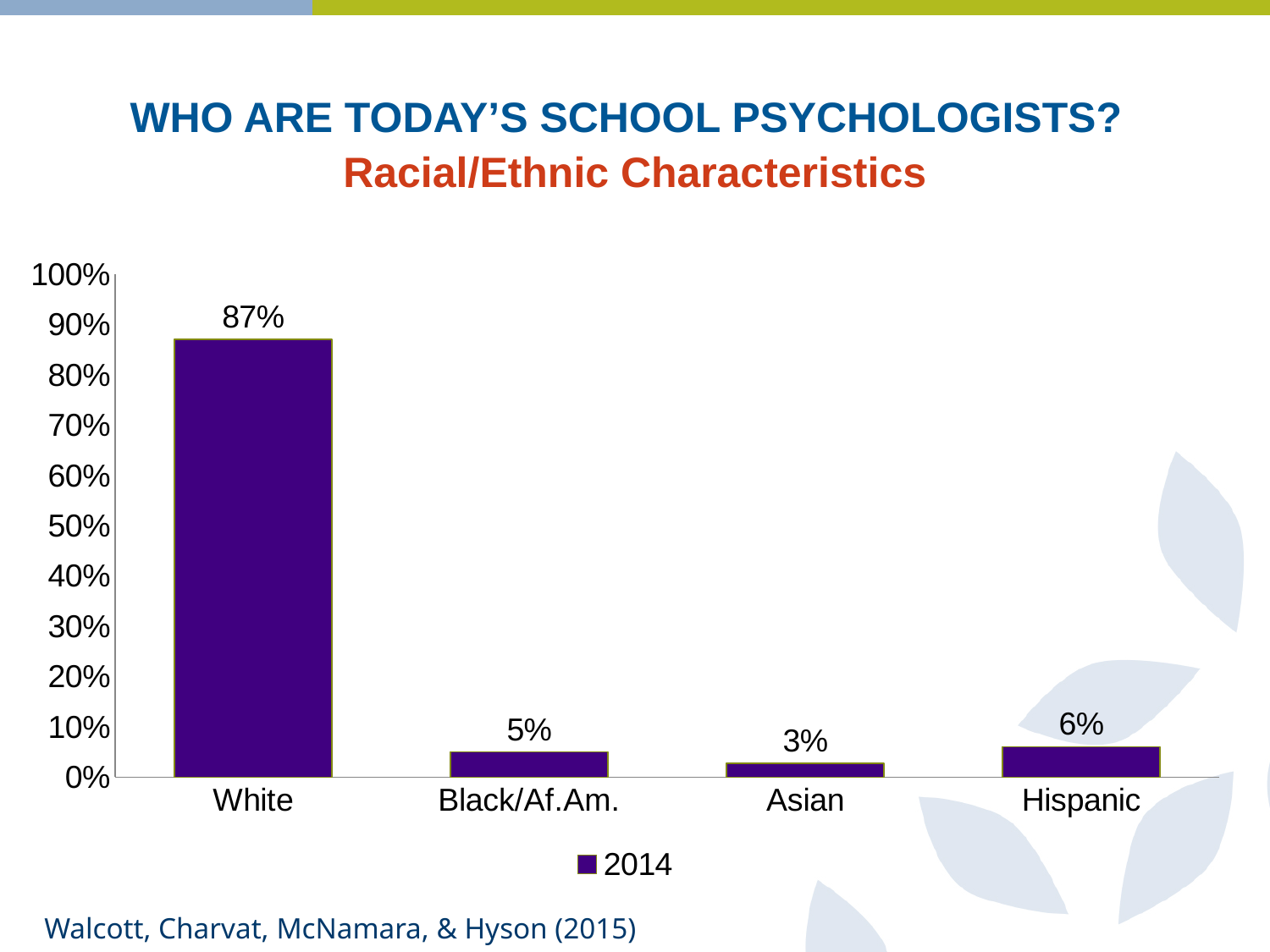
Is the value for White greater or less than 80%? greater How many categories are shown on the x axis? 4 What is the value shown for Black/Af.Am.? 5% What is the value shown for Asian? 3% Which category has the lowest value? Asian Which category has the highest value? White What percentage of school psychologists are White according to the chart? 87% Which is larger, the value for Hispanic or the value for Black/Af.Am.? Hispanic What is the difference between the White and Hispanic values? 81% What is the value shown for Hispanic? 6% What kind of chart is shown on the slide? Bar chart How many series does the legend list? 1